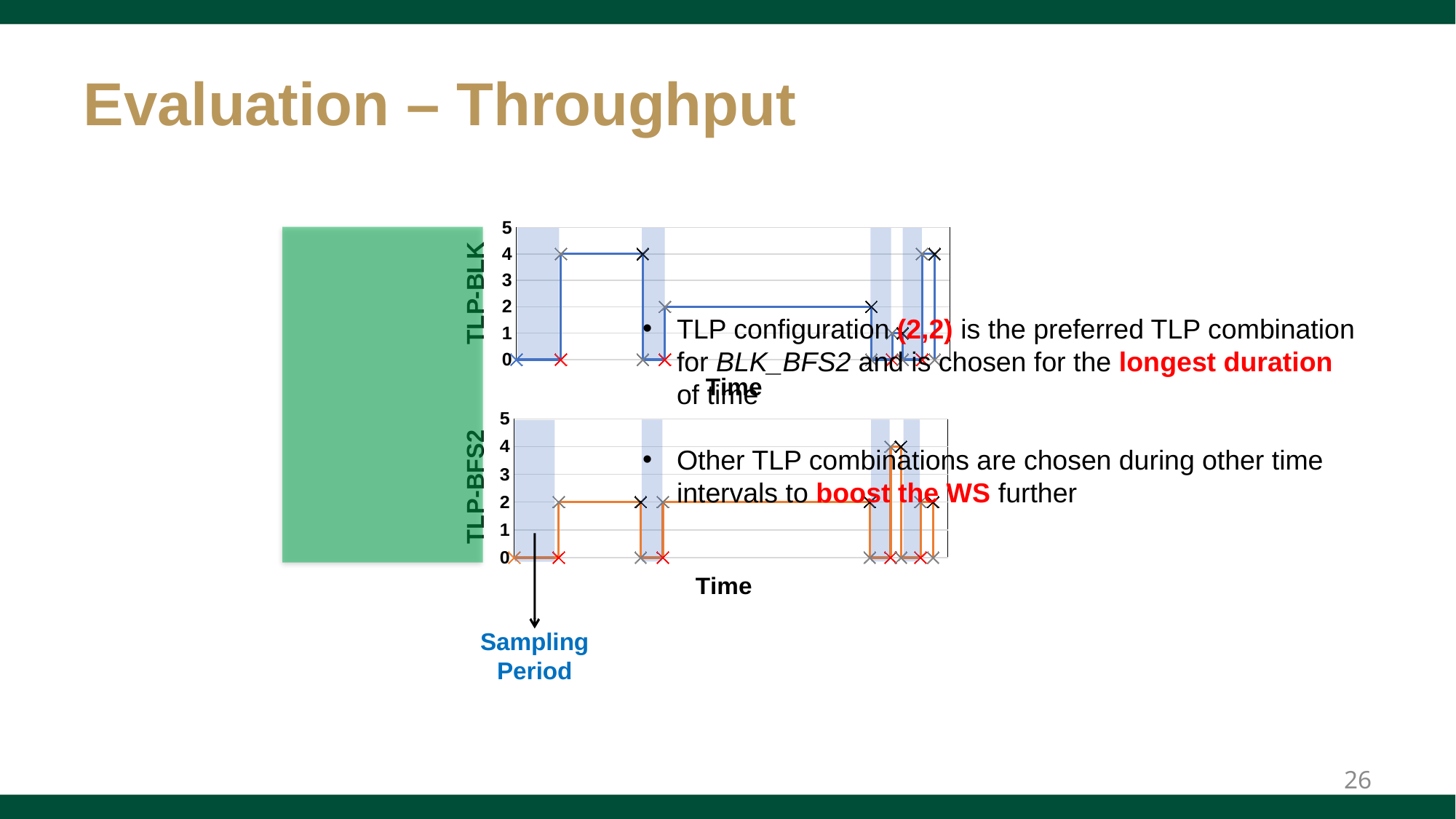
In the TLP-BLK chart, what is the highest tick value shown on the vertical axis? 5 In the TLP-BLK chart, what is the highest value the line reaches? 4 What is the difference between the first plateau value in the TLP-BLK chart (4) and the first plateau value in the TLP-BFS2 chart (2)? 2 In the TLP-BFS2 chart, at what value does the long plateau in the middle of the chart sit? 2 In the TLP-BFS2 chart, what is the highest value the line reaches? 4 What is the label on the vertical axis of the bottom chart? TLP-BFS2 What kind of chart is the top chart labelled TLP-BLK? line chart What is the label on the horizontal axis of the TLP-BFS2 chart? Time In the TLP-BLK chart, what is the lowest value the line reaches? 0 Is the first plateau of the TLP-BLK chart (just after the first shaded sampling period) greater or less than 3? greater In the TLP-BLK chart, at what value does the long plateau in the middle of the chart sit? 2 Which is larger: the first plateau value in the TLP-BLK chart or the first plateau value in the TLP-BFS2 chart? TLP-BLK